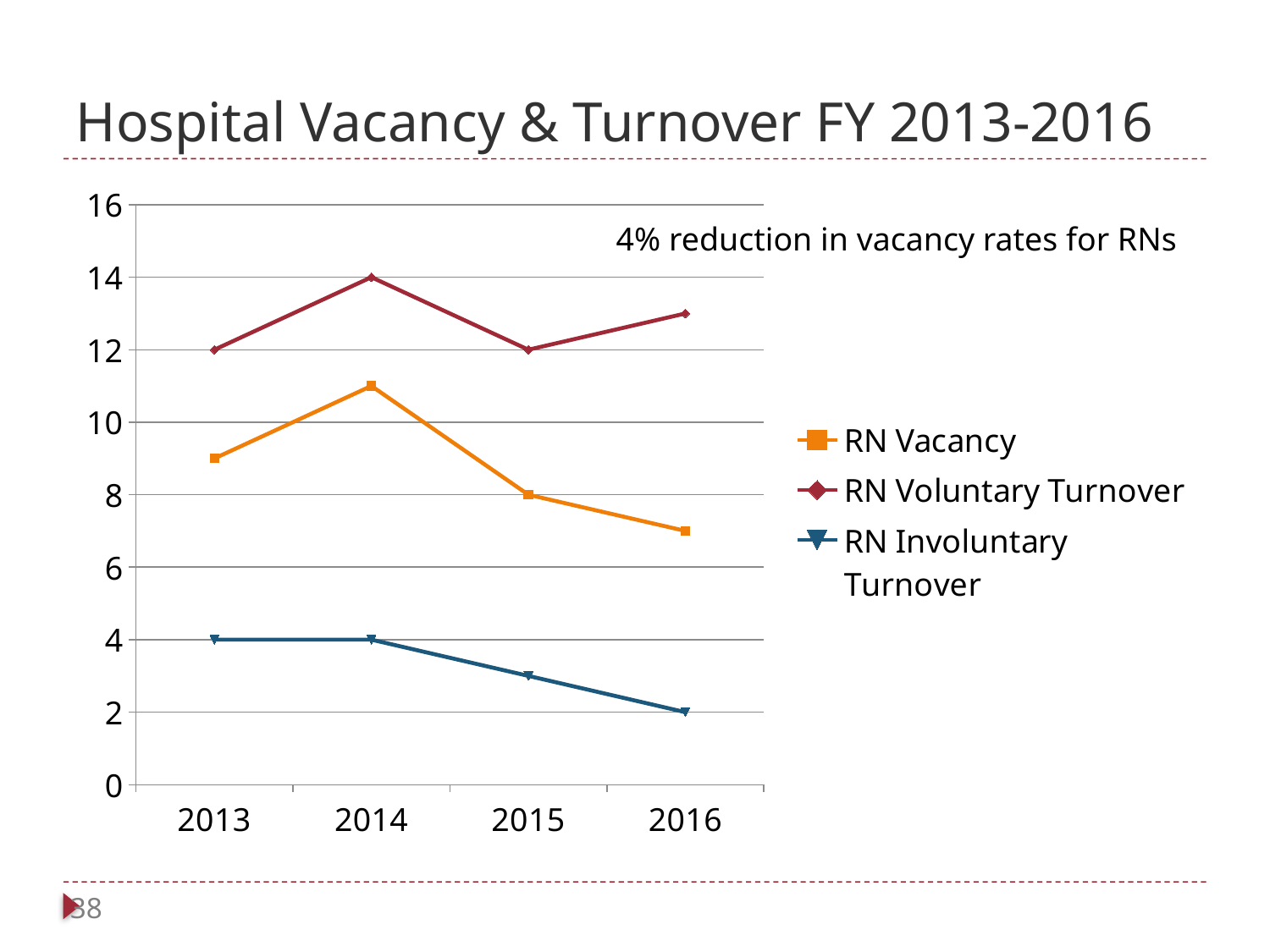
In which year is RN Voluntary Turnover highest? 2014 Does RN Involuntary Turnover rise or fall from 2014 to 2016? fall What kind of chart is shown on the slide? line chart What is the RN Involuntary Turnover value for 2013? 4 How many years are plotted along the x axis? 4 How many series does the legend list? 3 What is the RN Vacancy value for 2015? 8 Which series is higher in 2016, RN Vacancy or RN Voluntary Turnover? RN Voluntary Turnover Is the RN Vacancy value for 2014 greater or less than 10? greater What is the RN Voluntary Turnover value for 2014? 14 What is the RN Involuntary Turnover value for 2016? 2 In which year is RN Vacancy lowest? 2016